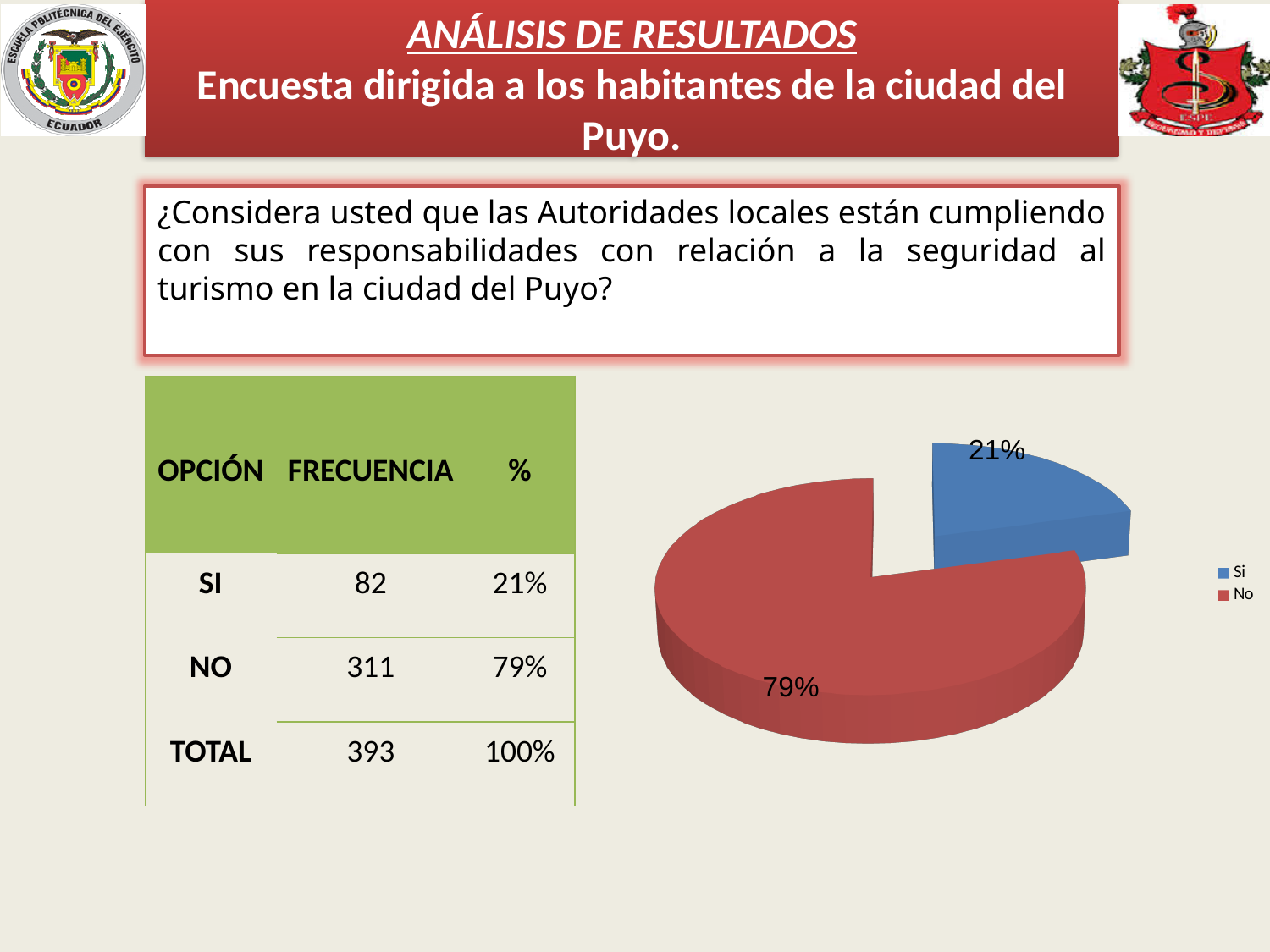
Which slice of the pie chart is the smallest? Si What percentage does the 'No' slice of the pie chart show? 79% How many slices does the pie chart have? 2 What share of the pie does the 'Si' slice represent? 21% How many entries does the legend of the pie chart list? 2 What is the difference in percentage points between the 'No' slice and the 'Si' slice? 58 What colour is the 'Si' slice in the pie chart? blue What percentage does the 'Si' slice of the pie chart show? 21% Which slice is larger in the pie chart, 'Si' or 'No'? No What colour is the 'No' slice in the pie chart? red Which slice of the pie chart is the largest? No What kind of chart is shown on the slide? pie chart